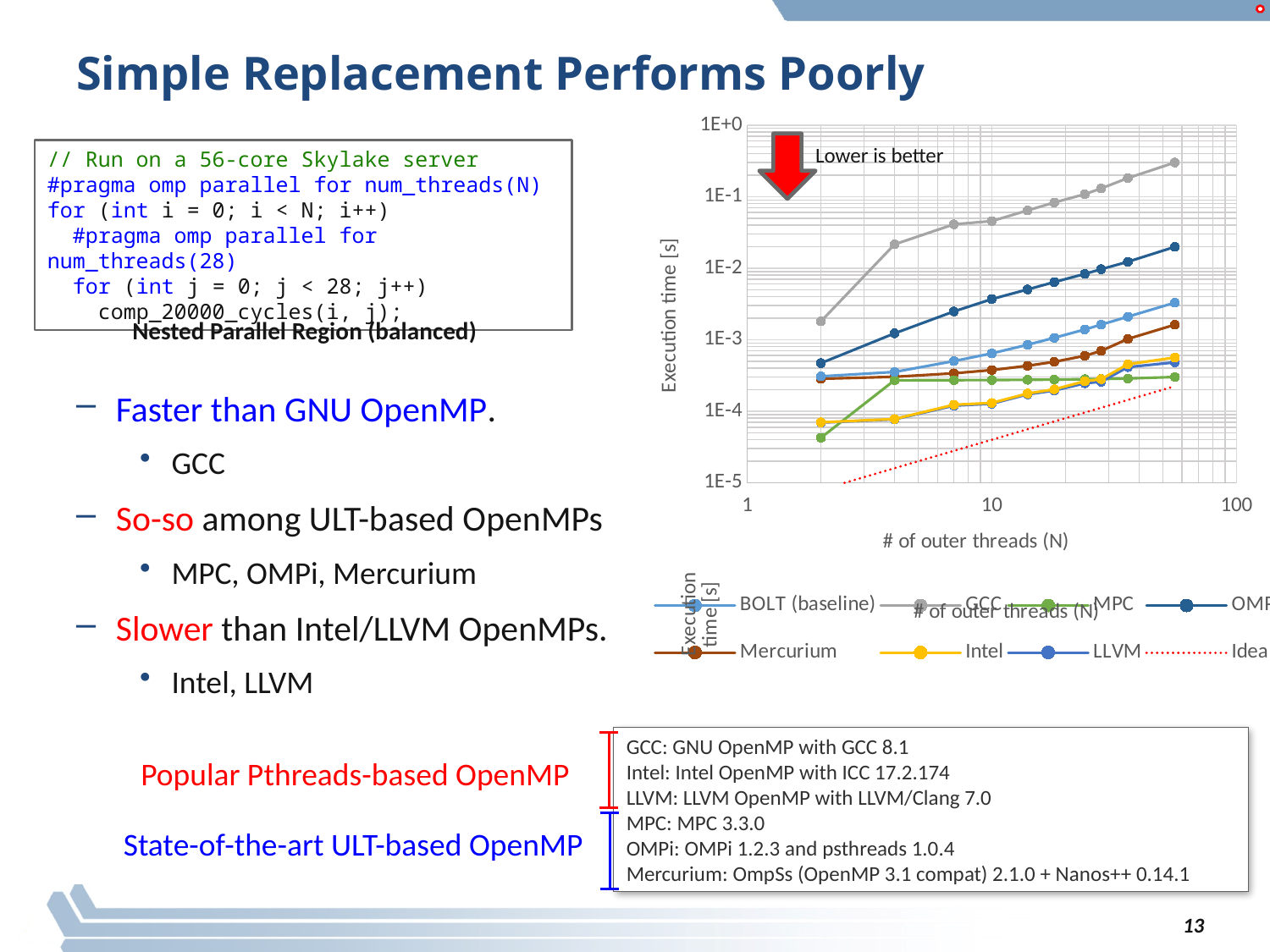
Is the execution time for GCC at the largest number of outer threads greater or less than 1E-1? greater What is the title of the y axis of the chart? Execution time [s] What kind of chart is shown on the slide? line chart How many series does the chart's legend list? 8 At the largest number of outer threads, which has the higher execution time, Mercurium or Intel? Mercurium Is the execution time for BOLT (baseline) at the largest number of outer threads greater or less than 1E-3? greater Does the execution time for GCC rise or fall as the number of outer threads increases? rise What is the title of the x axis of the chart? # of outer threads (N) At the largest number of outer threads, which has the higher execution time, GCC or BOLT (baseline)? GCC Which series has the highest execution time across the chart? GCC Is the execution time for Mercurium at the smallest number of outer threads greater or less than 1E-3? less